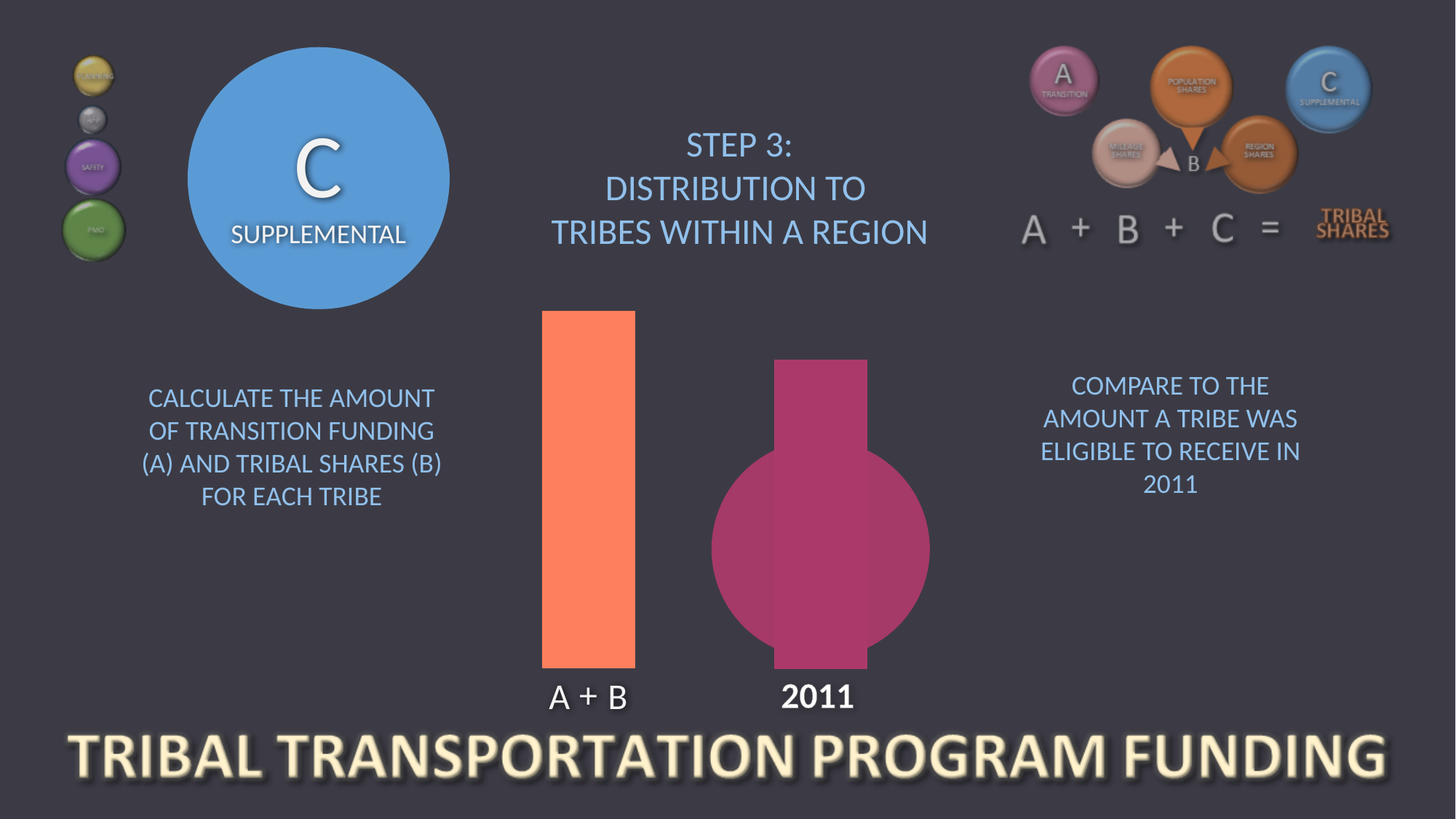
Which bar is taller in the centre graphic, A + B or 2011? A + B What are the labels under the two bars in the centre of the slide? A + B and 2011 How many bars are shown in the bar graphic in the centre of the slide? 2 What colour is the bar labelled A + B? Orange Which bar is shorter in the centre graphic, A + B or 2011? 2011